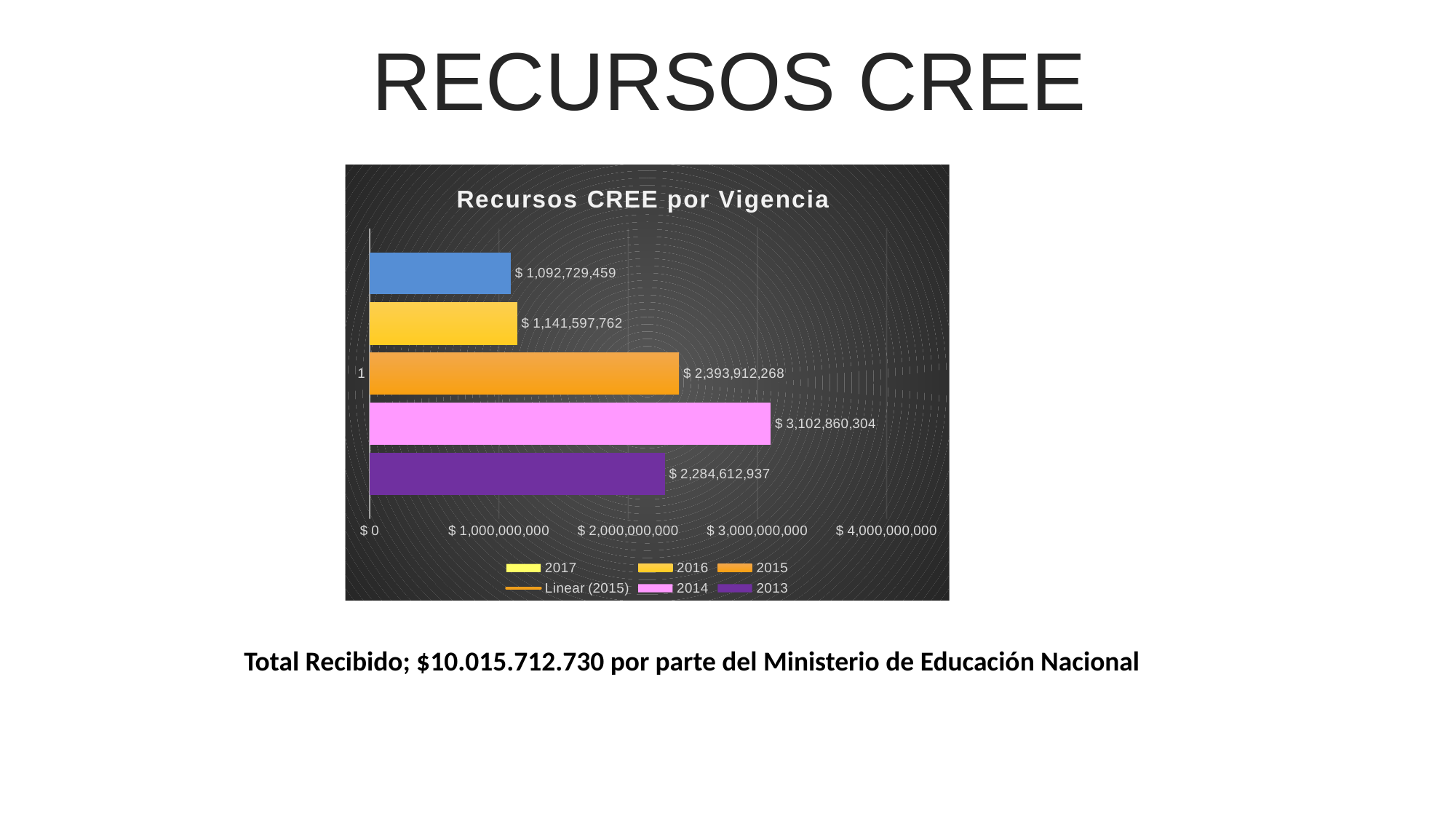
What is the value of the 2014 (pink) bar? $ 3,102,860,304 What is the title of the chart? Recursos CREE por Vigencia Which is larger, the 2015 bar or the 2013 bar? 2015 How many bars are plotted in the chart? 5 What is the value of the 2015 (orange) bar? $ 2,393,912,268 What is the difference between the 2014 bar and the 2013 bar? $ 818,247,367 How many entries does the legend list? 6 What type of chart is shown on the slide? Bar chart Is the value of the 2014 bar greater or less than $ 3,000,000,000? greater What is the value of the topmost (blue) bar? $ 1,092,729,459 What is the value of the 2013 (purple) bar? $ 2,284,612,937 Which series has the highest value? 2014